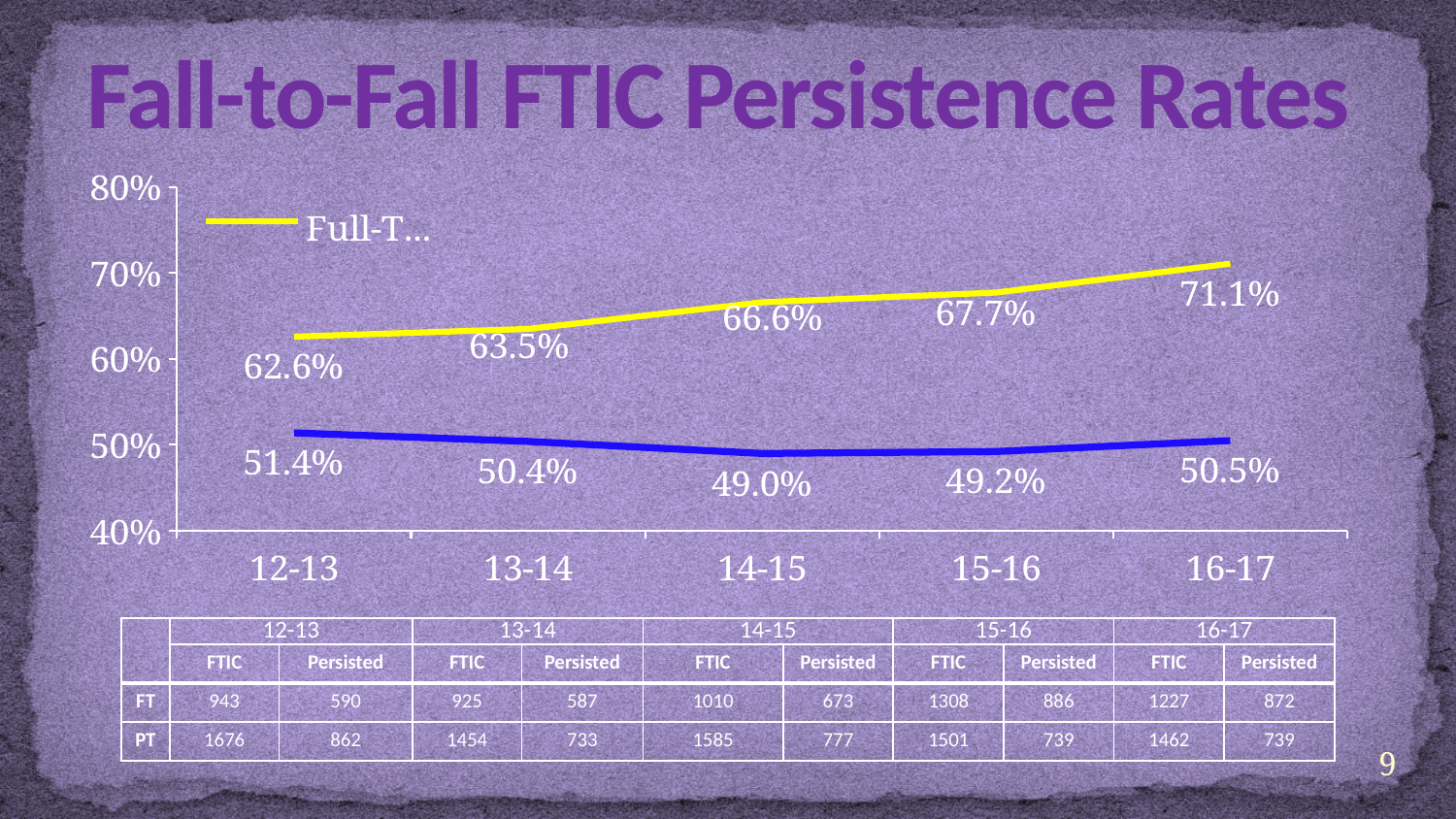
By how much did the yellow (Full-T...) line increase from 12-13 to 16-17? 8.5 percentage points In which year does the yellow (Full-T...) line reach its highest value? 16-17 What is the value of the blue line for 14-15? 49.0% What colour is the line labelled "Full-T..." in the legend? yellow What is the value of the yellow (Full-T...) line for 16-17? 71.1% For the blue line, which is larger: the value for 12-13 or the value for 16-17? 12-13 How many academic years are plotted along the x axis of the chart? 5 In which year does the blue line reach its lowest value? 14-15 Does the yellow (Full-T...) line rise or fall from 12-13 to 16-17? rise What kind of chart is shown on the slide? line chart What is the difference between the yellow line and the blue line in 12-13? 11.2 percentage points Is the value of the yellow line for 16-17 greater or less than 70%? greater